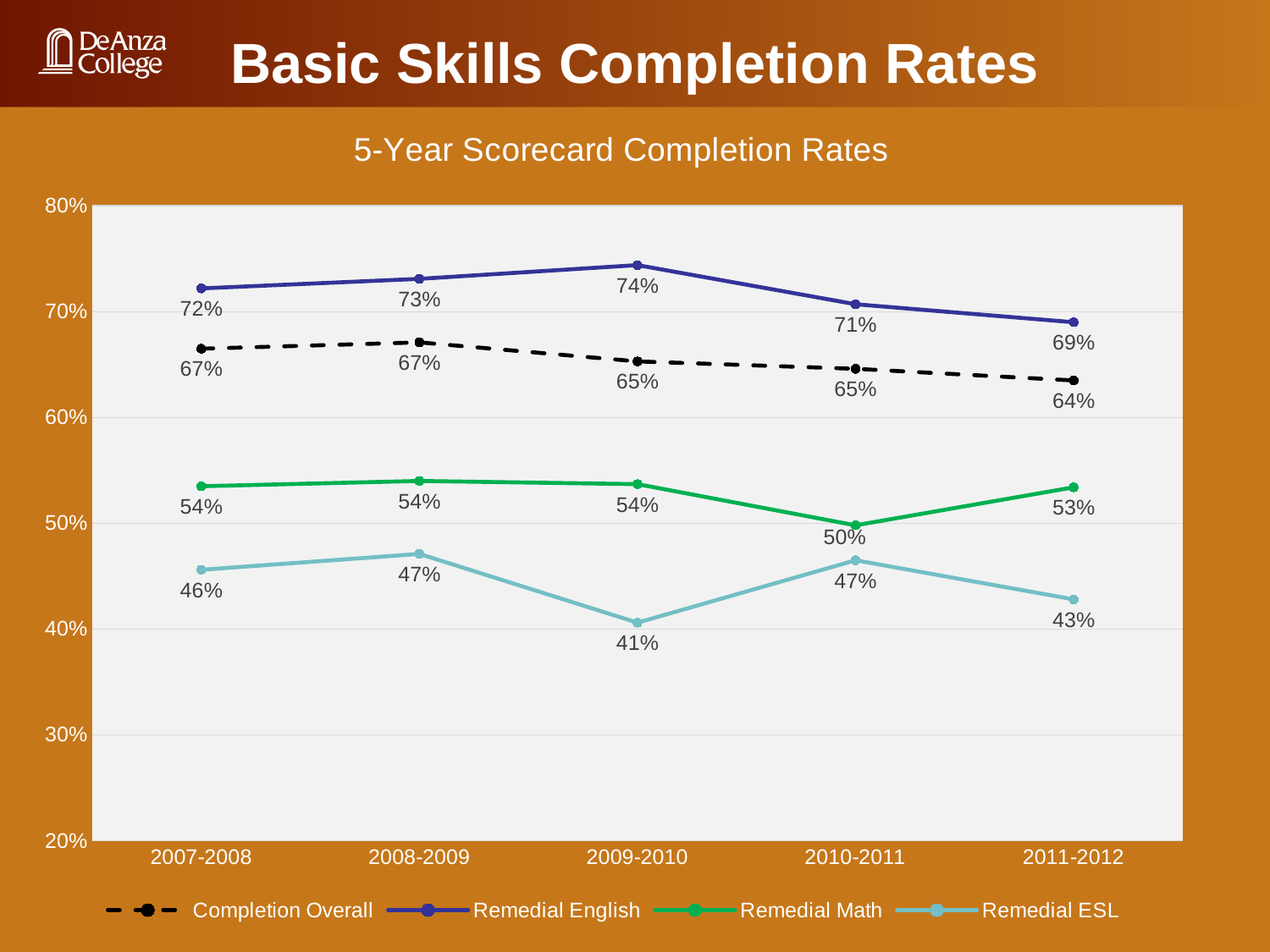
What is the difference between the Remedial English and Remedial ESL completion rates in 2011-2012? 26% What kind of chart is shown on the slide? Line chart How many series does the legend list? 4 What is the Remedial ESL completion rate for 2009-2010? 41% What is the Remedial English completion rate for 2009-2010? 74% Which is larger in 2010-2011: the Remedial Math rate or the Remedial ESL rate? Remedial Math In which year is the Remedial English completion rate highest? 2009-2010 What is the Remedial Math completion rate for 2010-2011? 50% In which year is the Remedial ESL completion rate lowest? 2009-2010 What is the Completion Overall rate for 2011-2012? 64% How many academic years are shown on the x axis? 5 Does the Remedial English completion rate rise or fall from 2009-2010 to 2011-2012? Fall